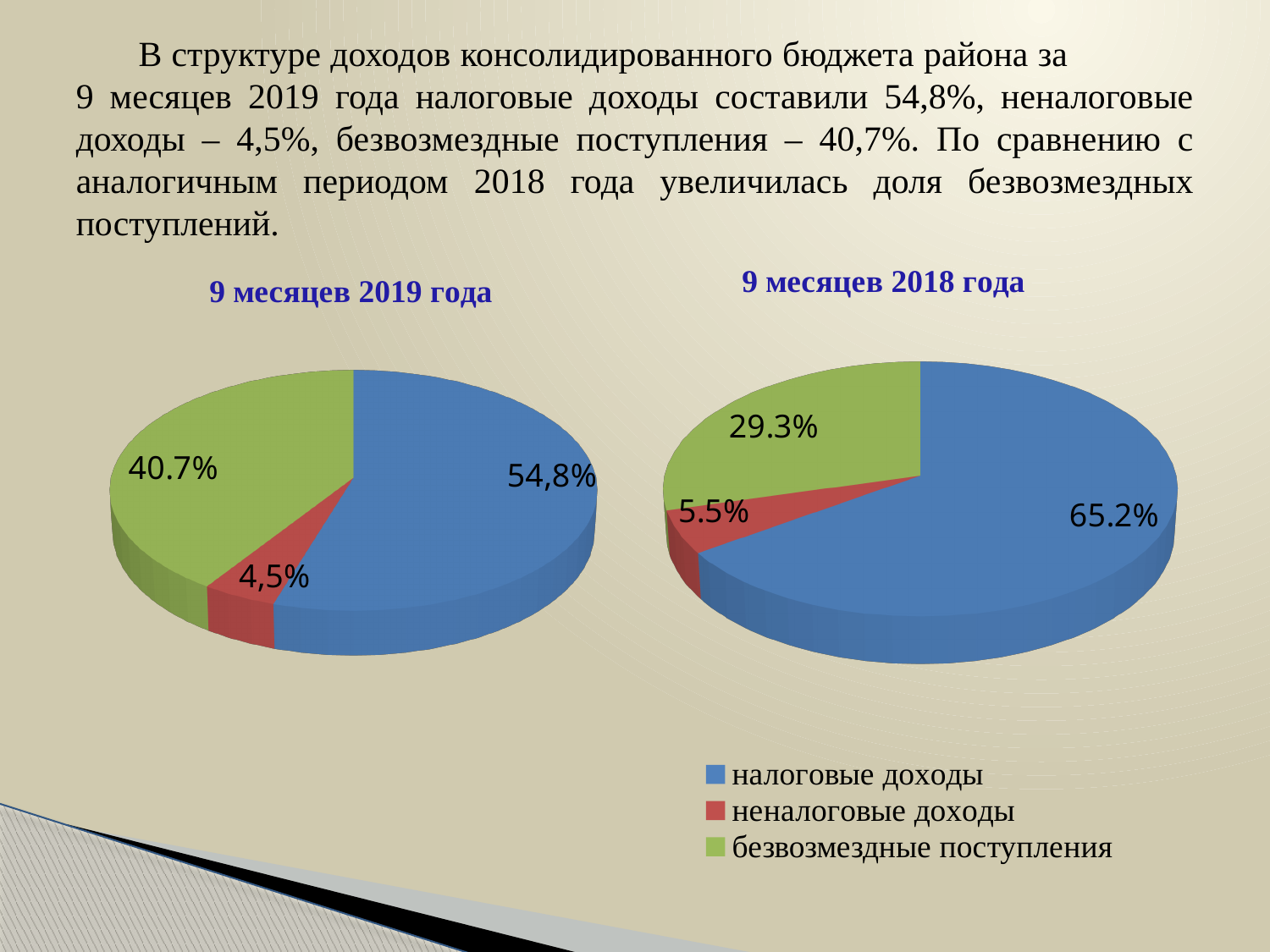
In the '9 месяцев 2018 года' pie chart, what is the value for неналоговые доходы? 5.5% In the '9 месяцев 2019 года' pie chart, what is the value for безвозмездные поступления? 40.7% Is the share of безвозмездные поступления larger in the '9 месяцев 2019 года' chart or the '9 месяцев 2018 года' chart? 9 месяцев 2019 года In the '9 месяцев 2018 года' pie chart, what is the value for безвозмездные поступления? 29.3% In the '9 месяцев 2018 года' pie chart, which category has the smallest share? неналоговые доходы What type of chart is used for '9 месяцев 2019 года'? pie chart In the '9 месяцев 2019 года' pie chart, which category has the largest share? налоговые доходы What is the difference between the налоговые доходы share in the '9 месяцев 2018 года' chart and in the '9 месяцев 2019 года' chart? 10.4 percentage points In the '9 месяцев 2018 года' pie chart, what is the value for налоговые доходы? 65.2% In the '9 месяцев 2019 года' pie chart, what is the value for налоговые доходы? 54,8% How many categories does the legend list? 3 In the '9 месяцев 2019 года' pie chart, which category has the smallest share? неналоговые доходы